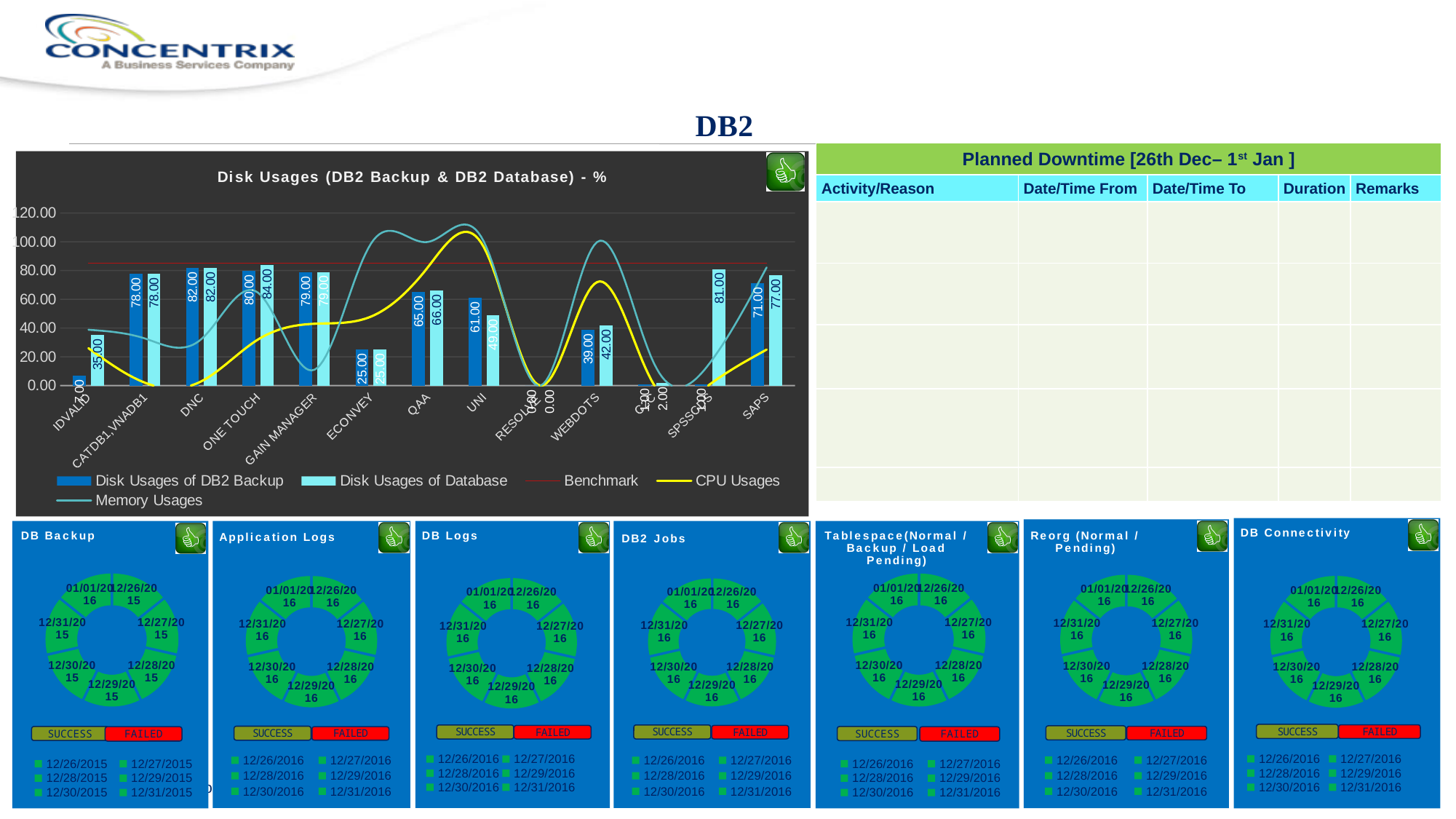
In the Disk Usages chart, what is the Disk Usages of Database value for ONE TOUCH? 84.00 In the Disk Usages chart, which is larger for WEBDOTS: Disk Usages of DB2 Backup or Disk Usages of Database? Disk Usages of Database How many series does the legend of the Disk Usages chart list? 5 In the Disk Usages chart, which category has the highest Disk Usages of Database bar? ONE TOUCH In the Disk Usages chart, what is the Disk Usages of Database value for SAPS? 77.00 In the Disk Usages chart, what is the Disk Usages of DB2 Backup value for UNI? 61.00 In the Disk Usages chart, what is the Disk Usages of DB2 Backup value for DNC? 82.00 What is the title of the large chart on the left of the slide? Disk Usages (DB2 Backup & DB2 Database) - % In the Disk Usages chart, which category has the highest Disk Usages of DB2 Backup bar? DNC In the Disk Usages chart, what is the difference between the Disk Usages of DB2 Backup and Disk Usages of Database values for UNI? 12.00 How many segments does the DB Backup donut chart at the bottom left have? 7 How many categories are shown on the x axis of the Disk Usages chart? 13